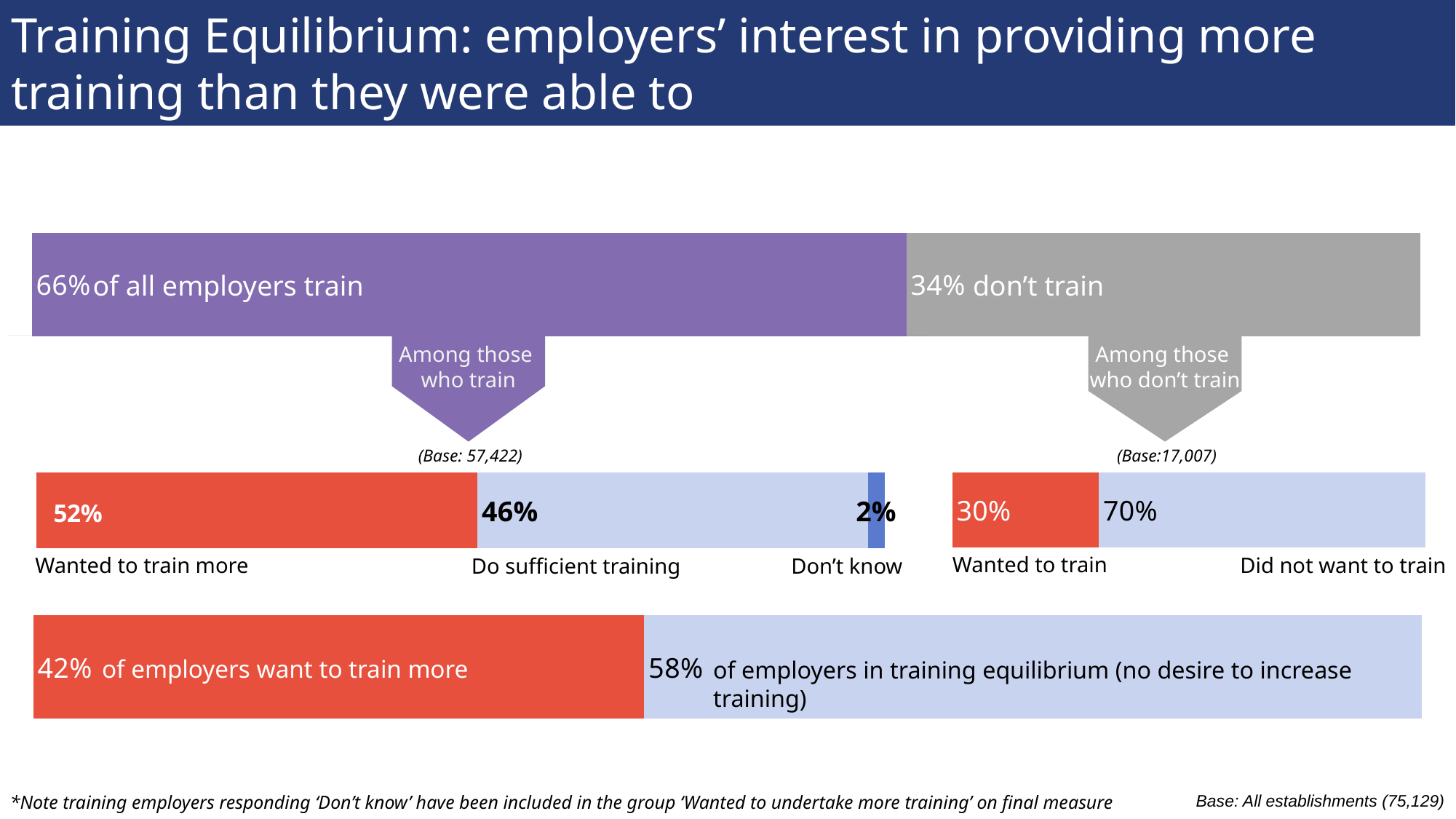
In the top bar showing all employers, what percentage of employers train? 66% In the 'Among those who train' bar, which category has the smallest share? Don't know In the bottom bar, what percentage of employers want to train more? 42% In the 'Among those who train' bar, what is the difference between 'Wanted to train more' and 'Do sufficient training'? 6% In the 'Among those who don't train' bar, which is larger: 'Wanted to train' or 'Did not want to train'? Did not want to train In the 'Among those who train' bar, what percentage answered 'Don't know'? 2% In the 'Among those who train' bar, what percentage do sufficient training? 46% What is the base shown for the 'Among those who train' bar? 57,422 In the 'Among those who don't train' bar, what percentage wanted to train? 30% In the bottom bar, what percentage of employers are in training equilibrium? 58% In the top bar showing all employers, what percentage of employers don't train? 34% In the 'Among those who train' bar, what percentage wanted to train more? 52%